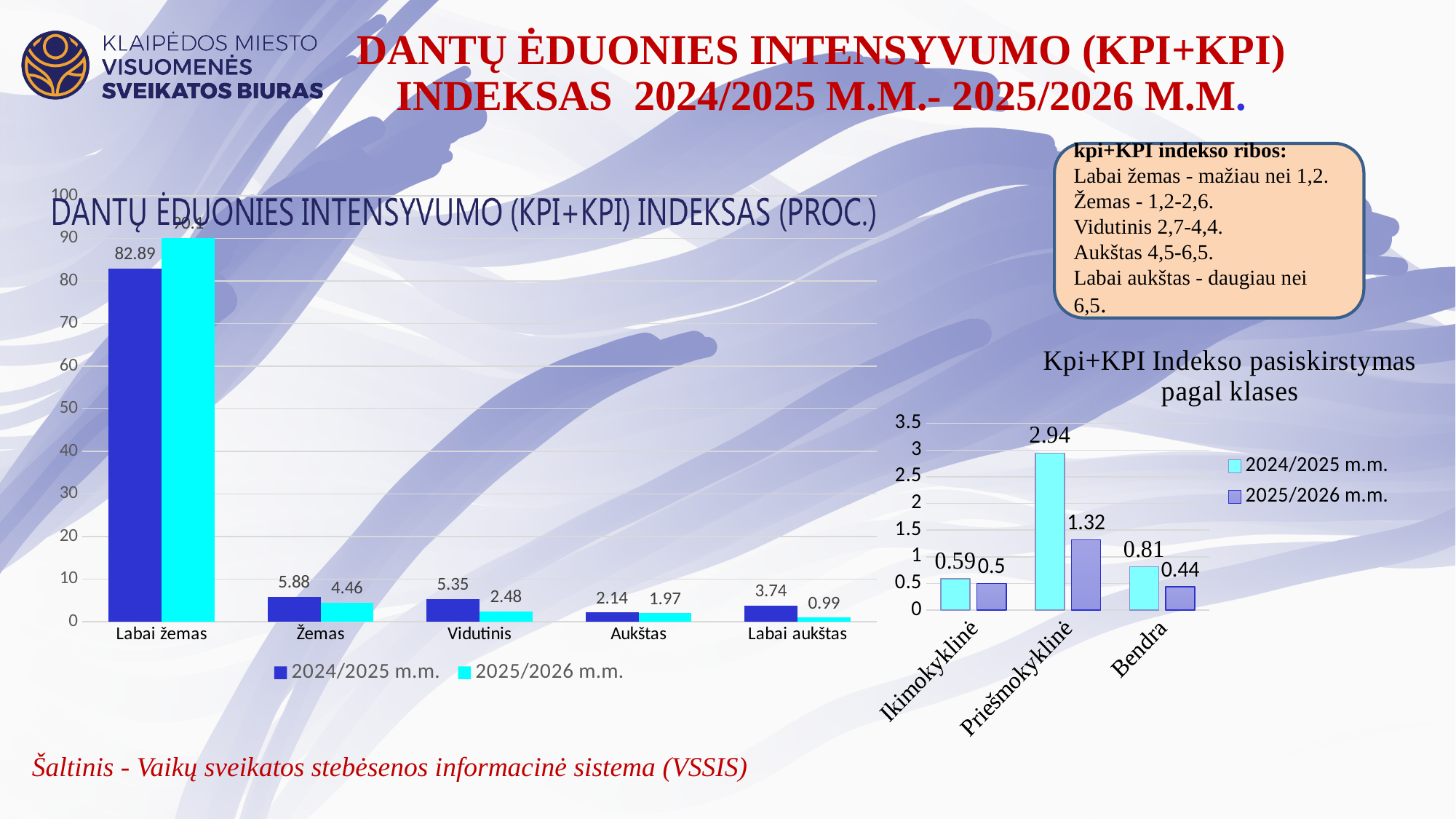
In the chart 'DANTŲ ĖDUONIES INTENSYVUMO (KPI+KPI) INDEKSAS (PROC.)', how many categories are shown on the x axis? 5 In the chart 'DANTŲ ĖDUONIES INTENSYVUMO (KPI+KPI) INDEKSAS (PROC.)', which category has the highest value for 2025/2026 m.m.? Labai žemas In the chart 'DANTŲ ĖDUONIES INTENSYVUMO (KPI+KPI) INDEKSAS (PROC.)', what is the value for Labai aukštas in 2025/2026 m.m.? 0.99 How many series does the legend of the chart 'Kpi+KPI Indekso pasiskirstymas pagal klases' list? 2 In the chart 'DANTŲ ĖDUONIES INTENSYVUMO (KPI+KPI) INDEKSAS (PROC.)', what is the difference between the 2024/2025 m.m. and 2025/2026 m.m. values for Vidutinis? 2.87 In the chart 'DANTŲ ĖDUONIES INTENSYVUMO (KPI+KPI) INDEKSAS (PROC.)', is the 2024/2025 m.m. value for Labai žemas greater or less than 80? greater In the chart 'Kpi+KPI Indekso pasiskirstymas pagal klases', what is the value for Priešmokyklinė in 2024/2025 m.m.? 2.94 In the chart 'Kpi+KPI Indekso pasiskirstymas pagal klases', which is larger: the 2024/2025 m.m. value for Ikimokyklinė or the 2024/2025 m.m. value for Bendra? Bendra In the chart 'Kpi+KPI Indekso pasiskirstymas pagal klases', which category has the lowest value for 2025/2026 m.m.? Bendra In the chart 'DANTŲ ĖDUONIES INTENSYVUMO (KPI+KPI) INDEKSAS (PROC.)', what is the value for Žemas in 2024/2025 m.m.? 5.88 In the chart 'DANTŲ ĖDUONIES INTENSYVUMO (KPI+KPI) INDEKSAS (PROC.)', what is the value for Labai žemas in 2024/2025 m.m.? 82.89 In the chart 'Kpi+KPI Indekso pasiskirstymas pagal klases', what is the value for Bendra in 2025/2026 m.m.? 0.44